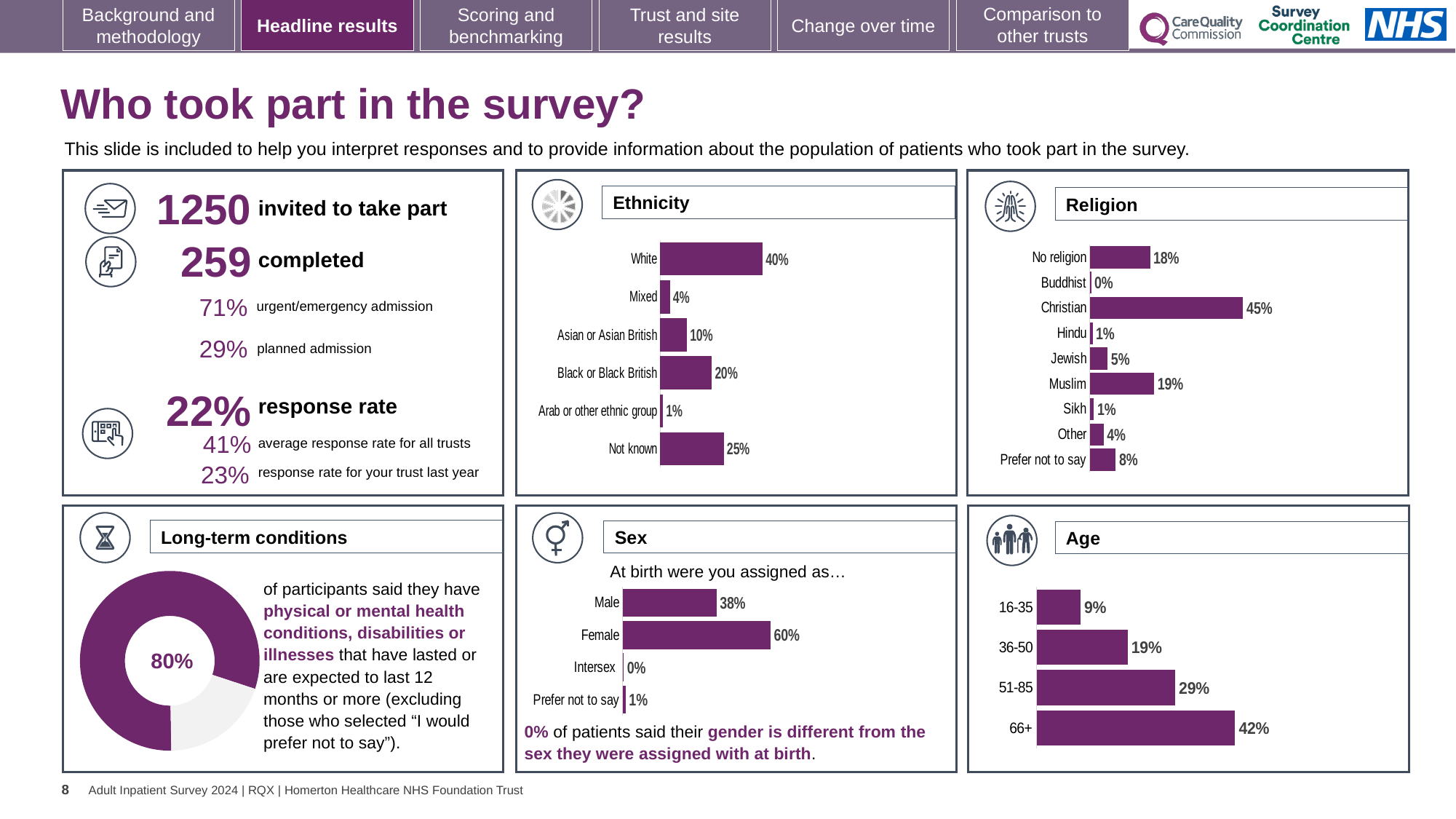
In the Ethnicity chart, how many categories are shown? 6 In the Sex chart, what is the value for Prefer not to say? 1% In the Age chart, do the values rise or fall as you move from the 16-35 group to the 66+ group? rise In the Sex chart, which is larger, the value for Male or the value for Female? Female In the Religion chart, what is the difference between the values for Christian and No religion? 27% In the Age chart, what is the difference between the values for 66+ and 51-85? 13% What kind of chart is used in the Long-term conditions panel? Doughnut chart In the Ethnicity chart, which category has the lowest value? Arab or other ethnic group In the Religion chart, which category has the highest value? Christian In the Ethnicity chart, what percentage of respondents were White? 40% In the Religion chart, what is the value for Muslim? 19% In the Religion chart, how many categories are shown? 9